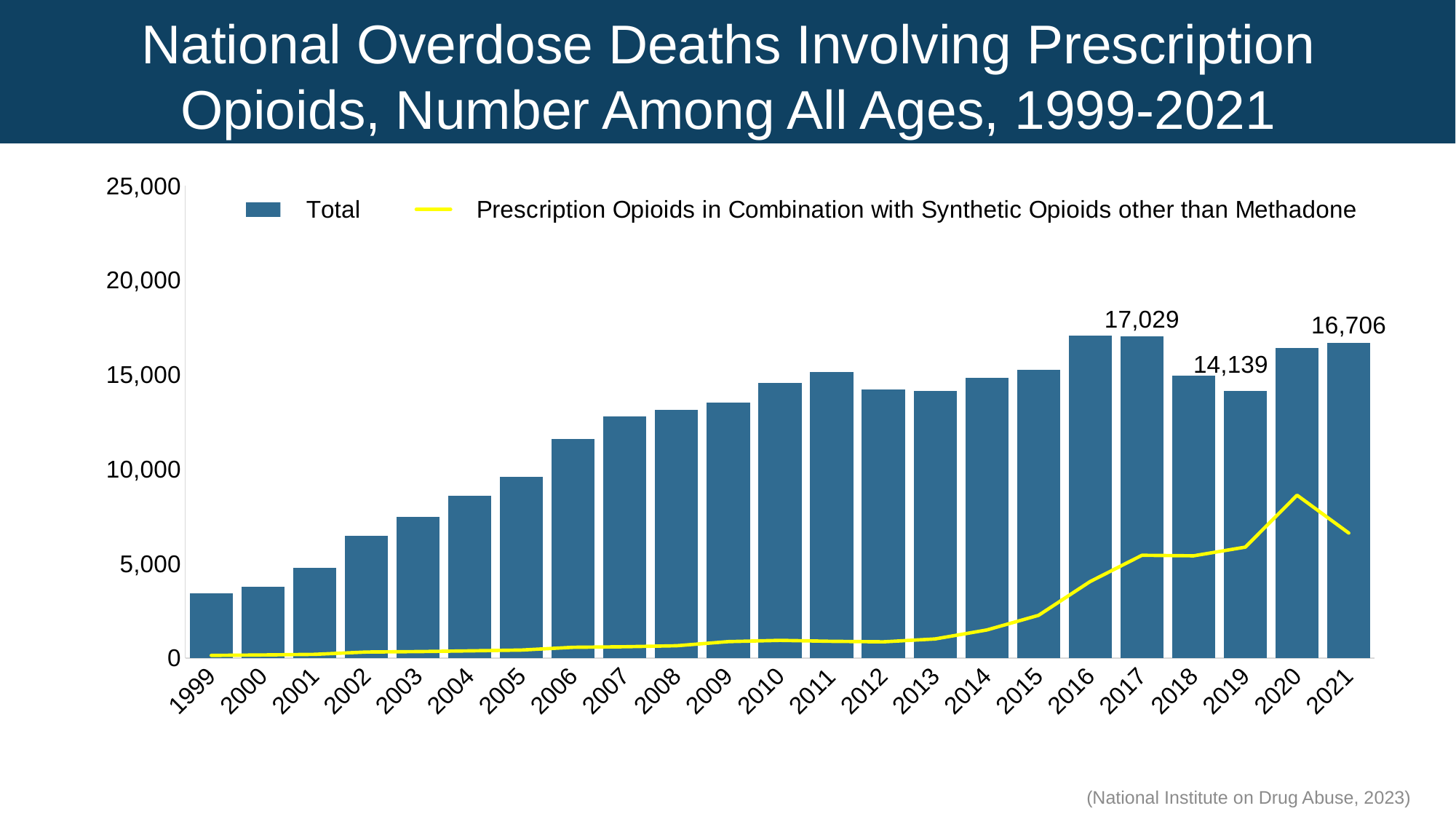
Is the Total value for 1999 greater or less than 5,000? less What is the Total value for 2019? 14,139 Is the Total value for 2006 greater or less than 10,000? greater In which year does the yellow line for Prescription Opioids in Combination with Synthetic Opioids other than Methadone reach its peak? 2020 What is the difference between the Total values for 2017 and 2021? 323 How many series does the legend list? 2 What is the Total value for 2017? 17,029 What is the Total value for 2021? 16,706 What is the difference between the Total values for 2017 and 2019? 2,890 Which is larger, the Total value for 2017 or for 2019? 2017 How many years are shown on the x axis? 23 Which year has the lowest Total value? 1999